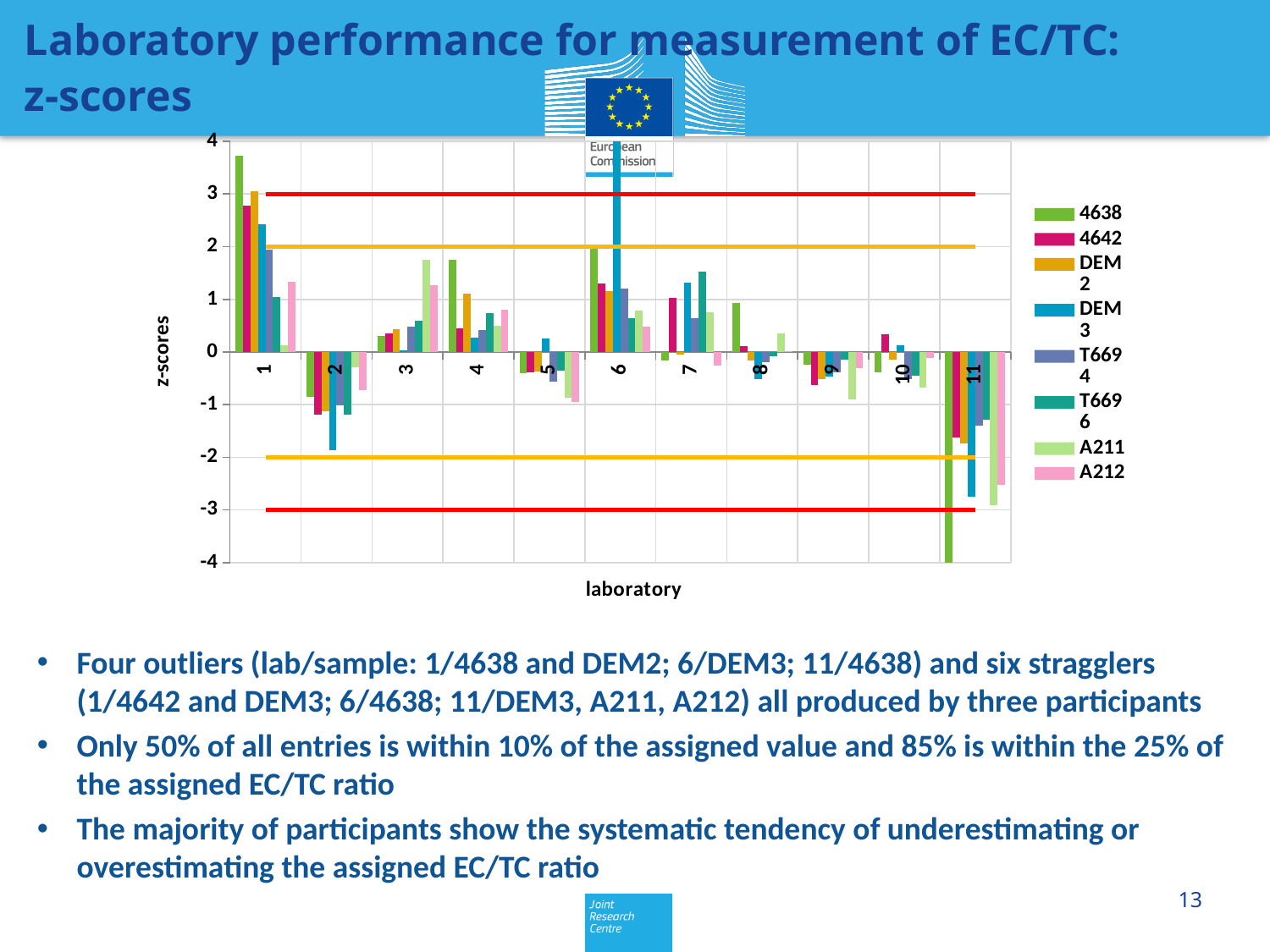
What kind of chart is shown on the slide? bar chart Which is larger, the z-score for sample 4638 at laboratory 1 or at laboratory 2? laboratory 1 How many series does the chart's legend list? 8 Is the z-score for sample DEM3 at laboratory 6 greater or less than 3? greater What is the label of the chart's y axis? z-scores Is the z-score for sample 4638 at laboratory 1 greater or less than 3? greater How many laboratories are shown along the x axis of the chart? 11 Is the z-score for sample DEM3 at laboratory 2 greater or less than -1? less What is the label of the chart's x axis? laboratory